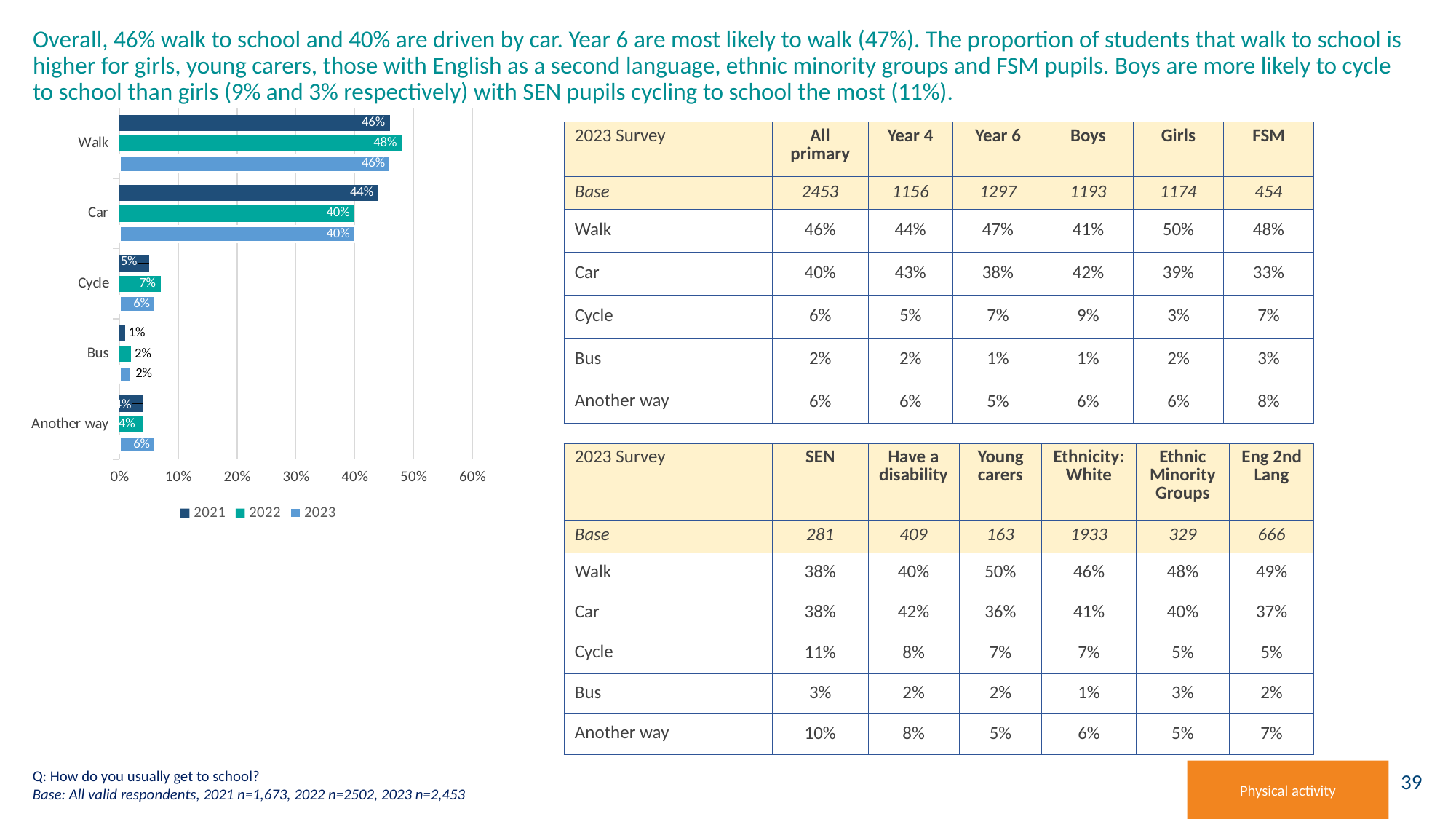
What is the 2021 value for Bus in the chart? 1% What is the difference between the 2021 and 2022 values for Car in the chart? 4% How many series does the chart legend list? 3 Which category has the highest 2023 value in the chart? Walk How many categories are shown on the chart's vertical axis? 5 What is the 2021 value for Car in the chart? 44% What is the 2023 value for Cycle in the chart? 6% In the chart, is the 2022 value for Walk or the 2022 value for Car larger? Walk What kind of chart is shown on the left of the slide? bar chart What is the 2022 value for Walk in the chart? 48% Which series in the chart legend is shown in the darkest blue? 2021 Which category has the lowest 2022 value in the chart? Bus